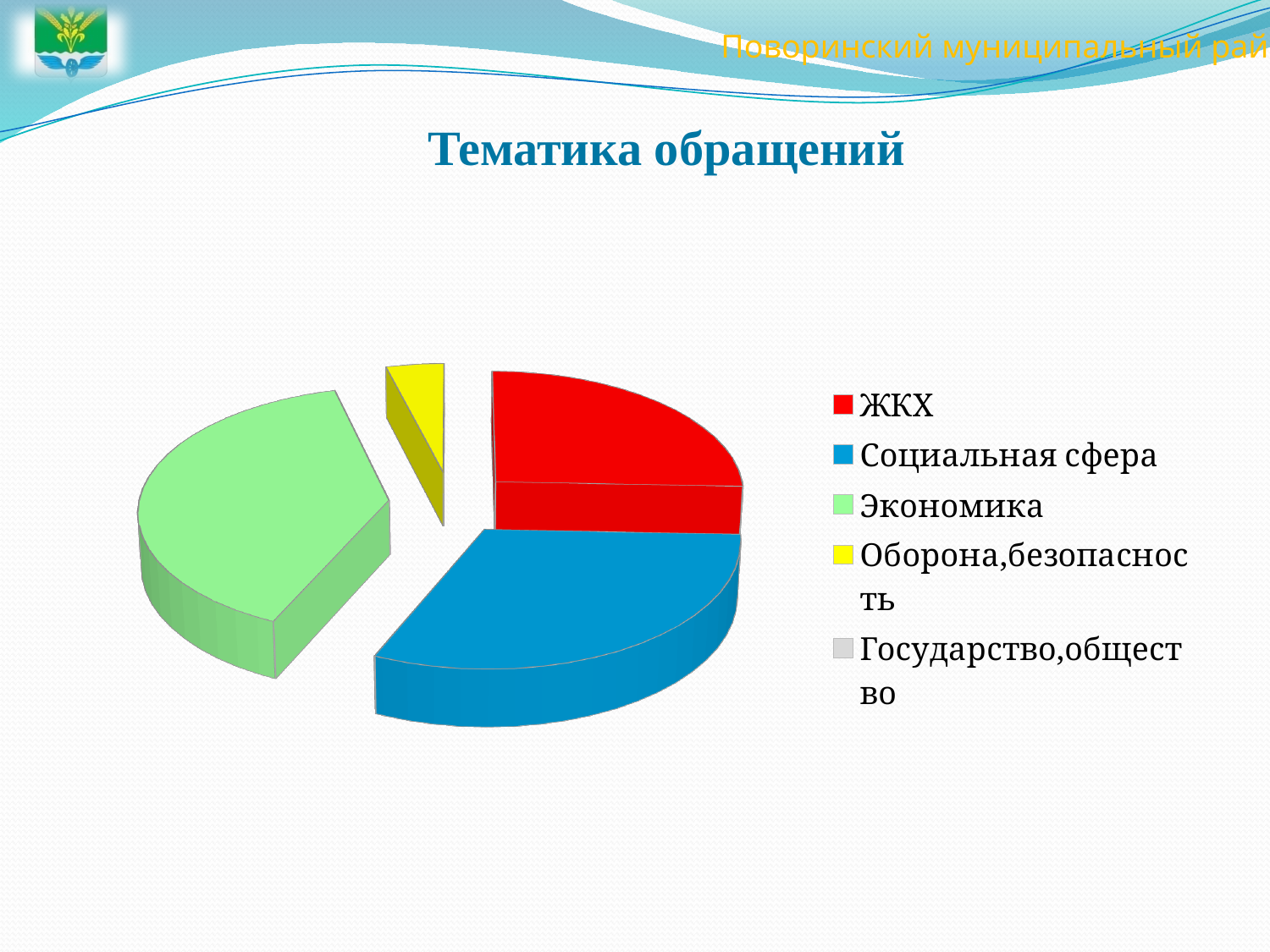
Which slice is larger, Экономика or Оборона,безопасность? Экономика Which of the visible slices is the smallest? Оборона,безопасность What is the title of the chart? Тематика обращений What colour is the slice for ЖКХ? red Which category has the largest slice of the pie? Экономика What kind of chart is shown on the slide? pie chart Which slice is larger, Социальная сфера or Экономика? Экономика Which slice is larger, Социальная сфера or ЖКХ? Социальная сфера How many categories does the legend list? 5